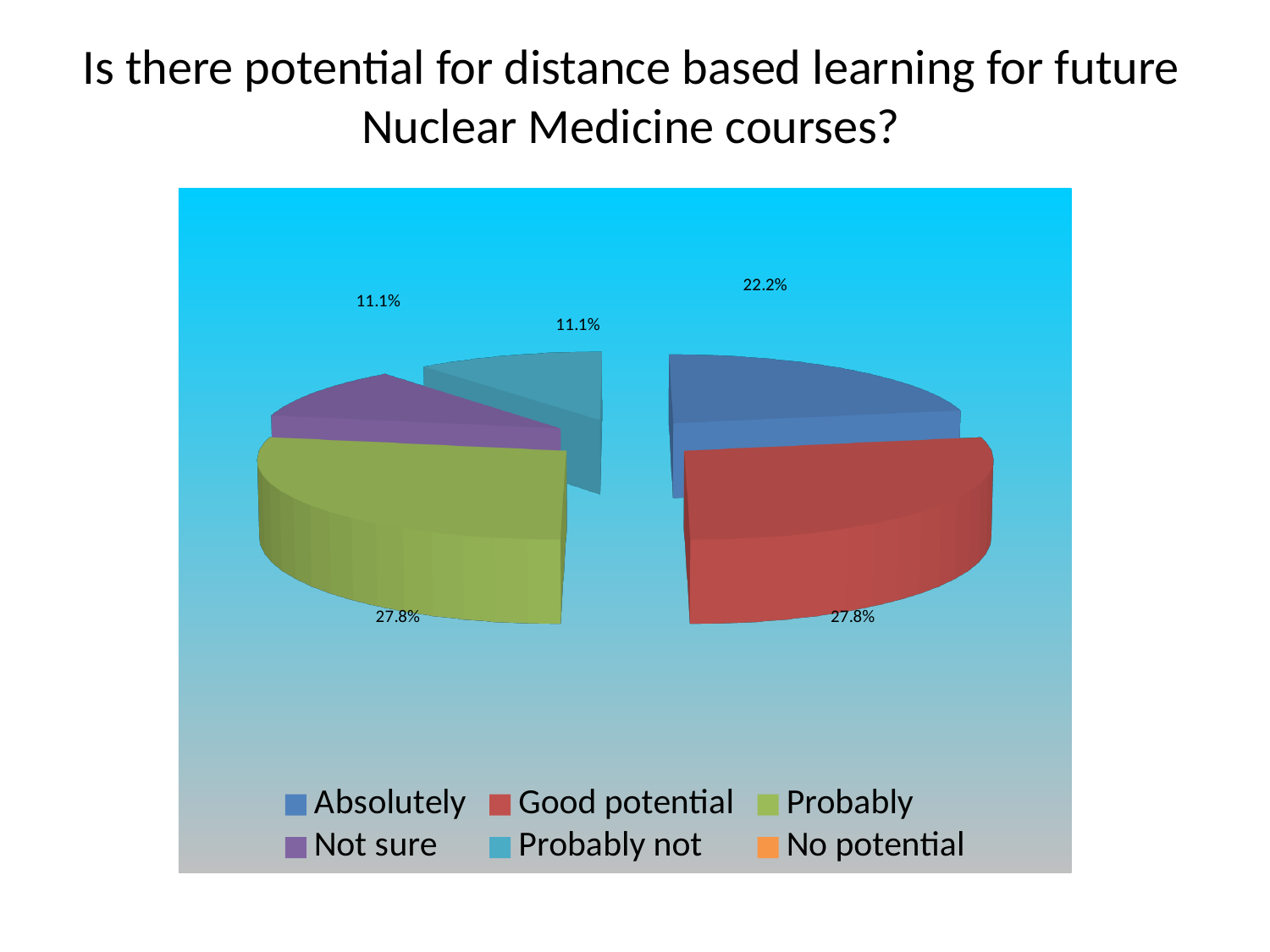
What share of the pie does the 'Absolutely' slice represent? 22.2% What is the value shown for 'Good potential'? 27.8% Which is larger, the share for 'Absolutely' or the share for 'Not sure'? Absolutely How many categories does the legend list? 6 What is the title of the slide containing the chart? Is there potential for distance based learning for future Nuclear Medicine courses? What is the value shown for 'Probably not'? 11.1% What is the value shown for 'Not sure'? 11.1% What kind of chart is shown on the slide? pie chart What is the difference between the share for 'Absolutely' and the share for 'Probably not'? 11.1% Which colour represents 'Probably' in the legend? green What is the difference between the share for 'Good potential' and the share for 'Absolutely'? 5.6% What is the value shown for 'Probably'? 27.8%